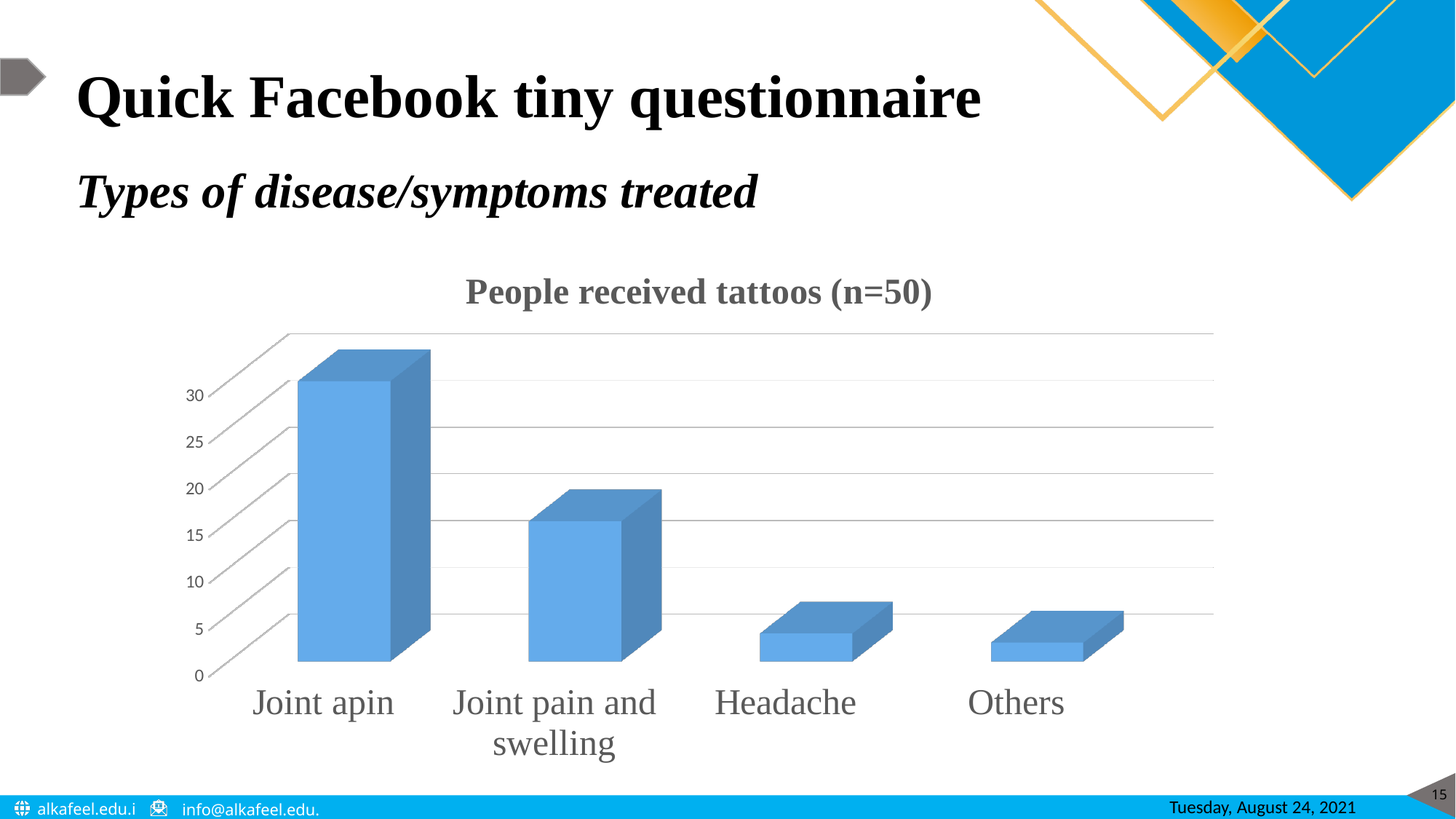
Which category has the highest value in the chart? Joint apin What kind of chart is shown on the slide? bar chart Is the value for Joint pain and swelling greater or less than 20? less Which is larger, the value for Joint apin or the value for Joint pain and swelling? Joint apin Is the value for Others greater or less than 5? less What is the title of the chart? People received tattoos (n=50) Is the value for Joint pain and swelling greater or less than 10? greater How many categories are shown on the x axis of the chart? 4 Which is larger, the value for Joint pain and swelling or the value for Headache? Joint pain and swelling Do the values rise or fall moving from left to right along the x axis? fall